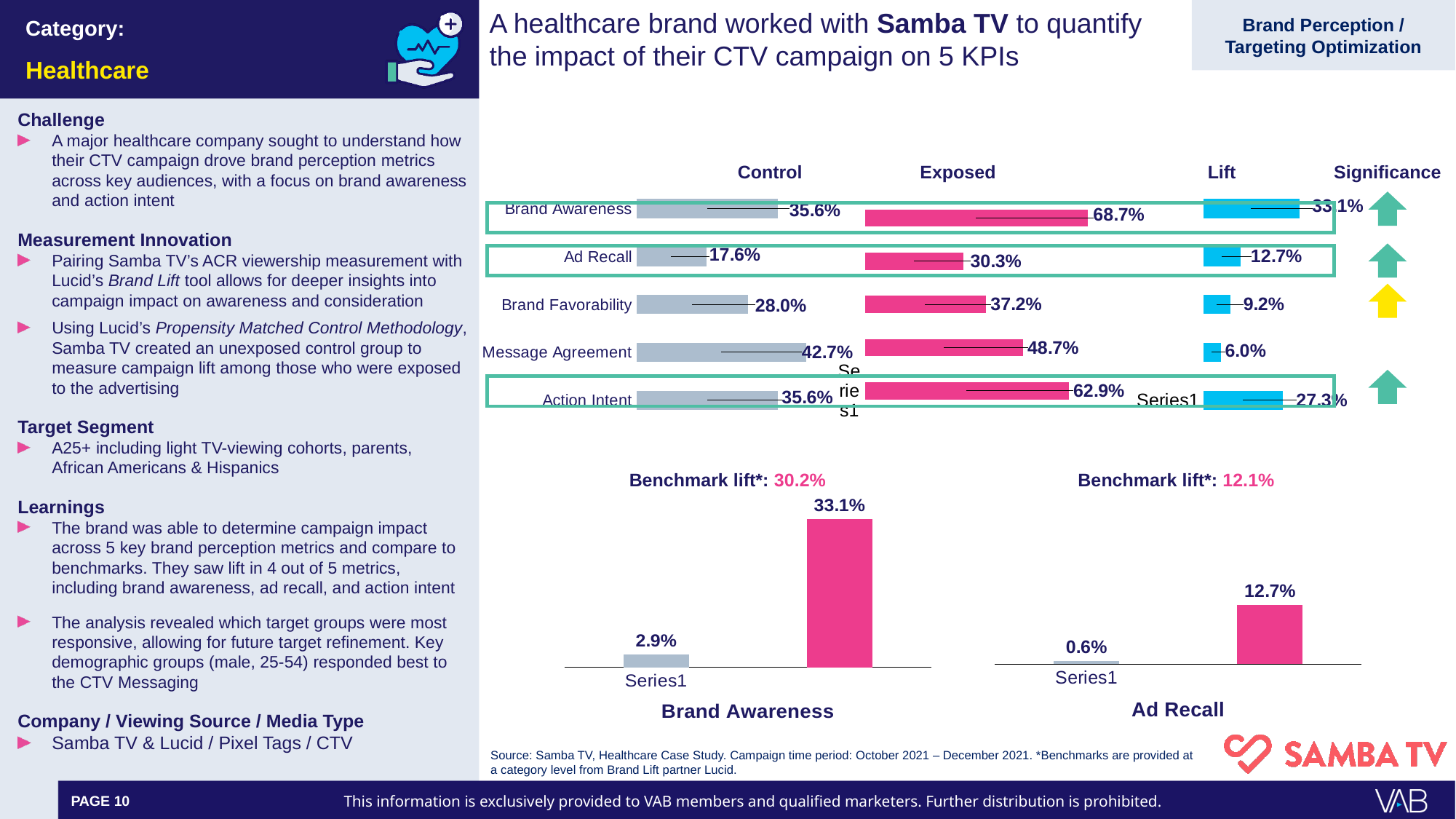
In the top chart, what is the Exposed value for Brand Awareness? 68.7% In the top chart, which KPI has the lowest Control value? Ad Recall In the top chart, which is larger: the Exposed value for Brand Favorability or the Exposed value for Message Agreement? Message Agreement In the bottom-left Brand Awareness chart, what is the value of the grey bar? 2.9% In the top chart, what is the Control value for Ad Recall? 17.6% In the top chart, which KPI has the highest Lift value? Brand Awareness In the top chart, what is the difference between the Exposed and Control values for Action Intent? 27.3% In the top chart, what is the Lift value for Message Agreement? 6.0% In the bottom-right Ad Recall chart, what is the value of the pink bar? 12.7% How many KPIs are shown in the top chart? 5 In the bottom-right Ad Recall chart, what is the difference between the pink bar and the grey bar? 12.1% What type of chart is the bottom-left Brand Awareness chart? Bar chart